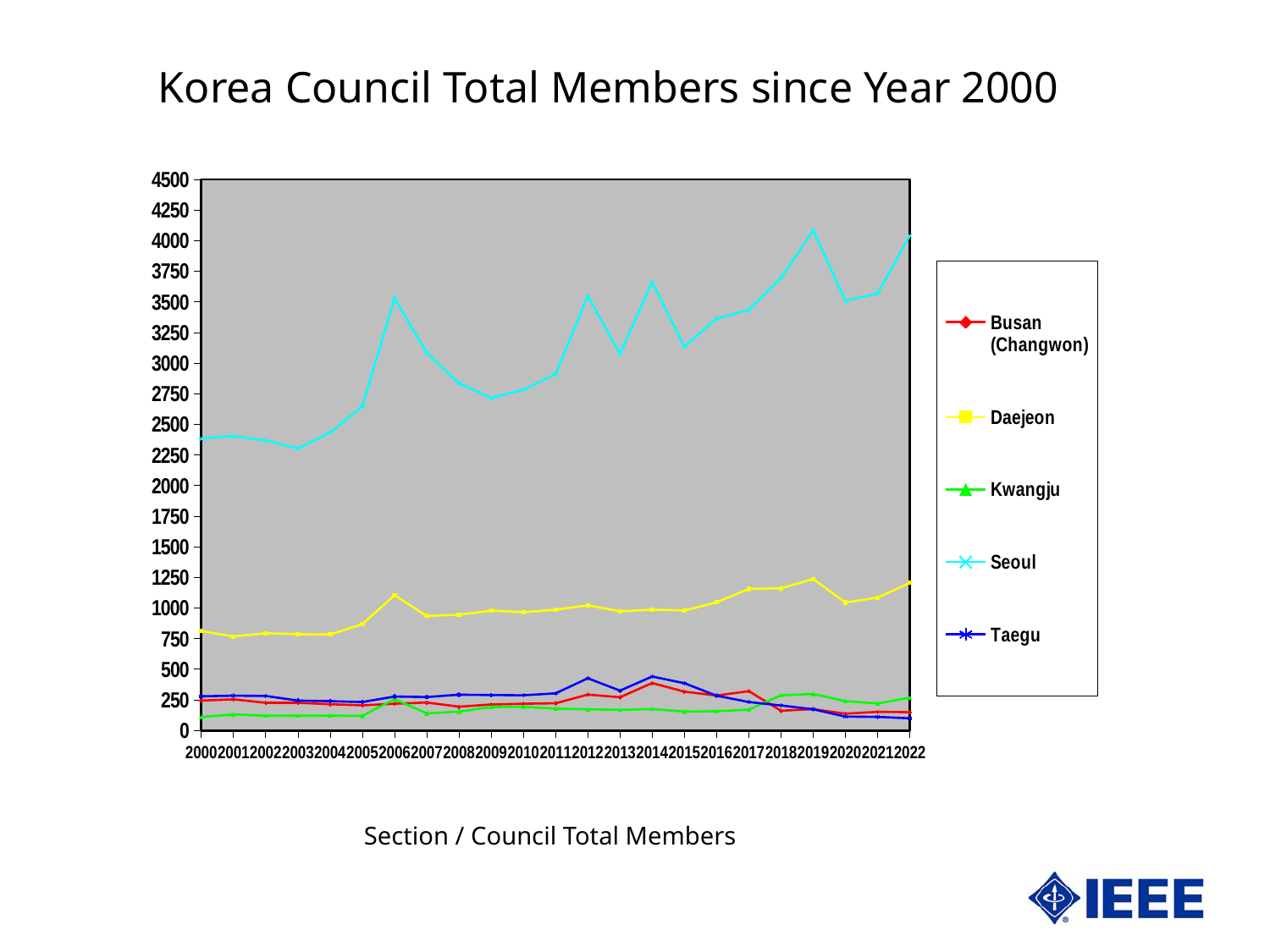
Is the value for Seoul in 2003 greater or less than 2000? greater Is the value for Seoul in 2000 greater or less than 2500? less Is the value for Daejeon in 2000 greater or less than 1000? less Which council has the lowest total members in 2000? Kwangju What is the title of the chart? Korea Council Total Members since Year 2000 Which council has the highest total members across the whole period? Seoul What kind of chart is shown on the slide? line chart Does the Seoul series generally rise or fall from 2000 to 2022? rise Which is larger in 2022, the value for Daejeon or the value for Kwangju? Daejeon How many years are plotted along the x axis? 23 How many series does the legend list? 5